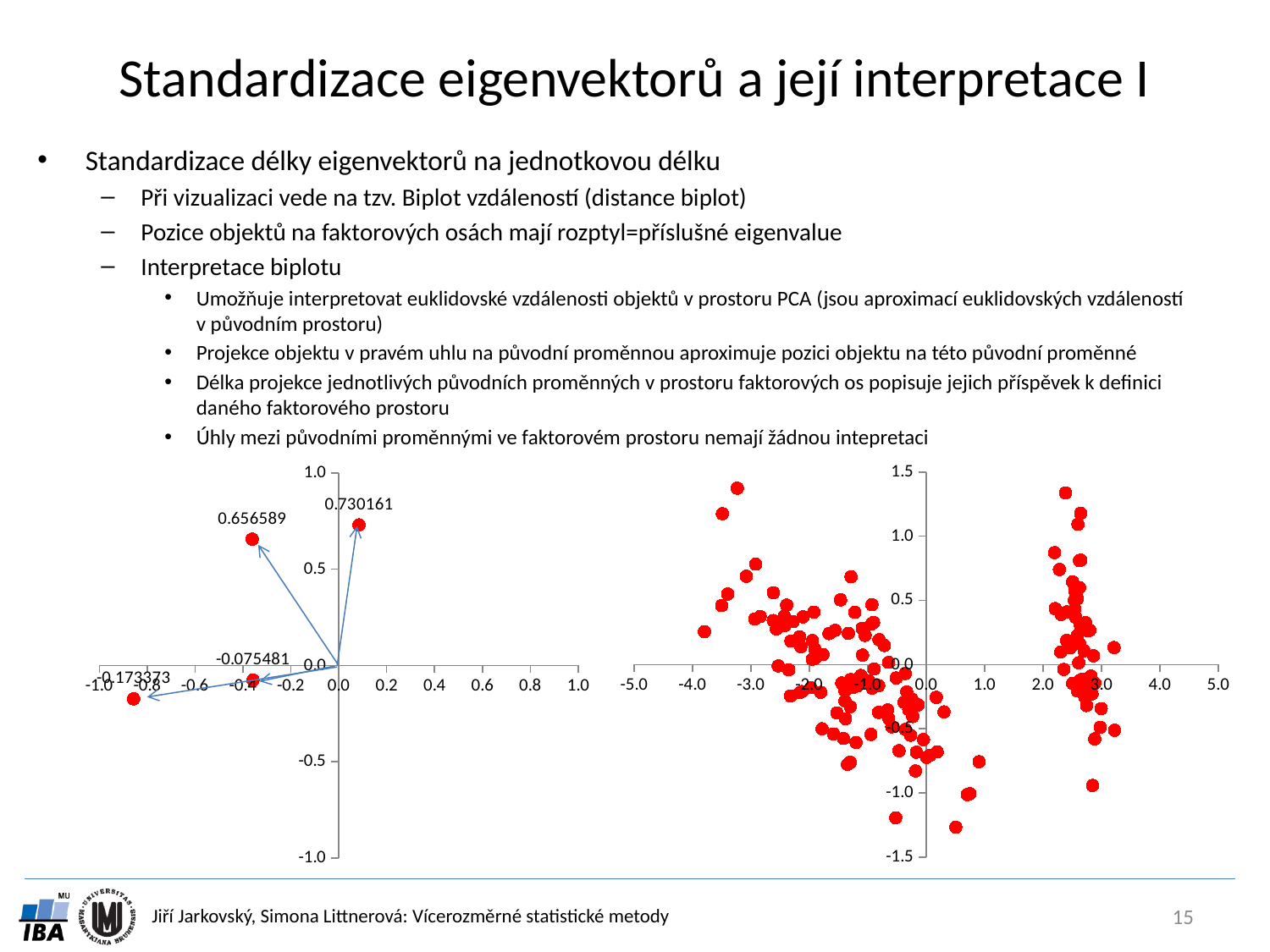
In the left chart, how many of the data labels are negative? 2 What kind of chart is the left chart on the slide? scatter chart In the left chart, how many data points are plotted? 4 In the left chart, what is the difference between the data labels 0.730161 and 0.656589? 0.073572 In the left chart, what is the lowest data label value shown? -0.173373 In the left chart, what is the highest data label value shown? 0.730161 In the left chart, which is larger: the data label 0.656589 or the data label -0.075481? 0.656589 What kind of chart is the right chart on the slide? scatter chart In the left chart, what is the maximum value shown on the vertical axis? 1.0 In the right chart, what is the maximum value shown on the vertical axis? 1.5 In the right chart, what is the maximum value shown on the horizontal axis? 5.0 In the left chart, is the point labelled 0.730161 above or below 0.5 on the vertical axis? above